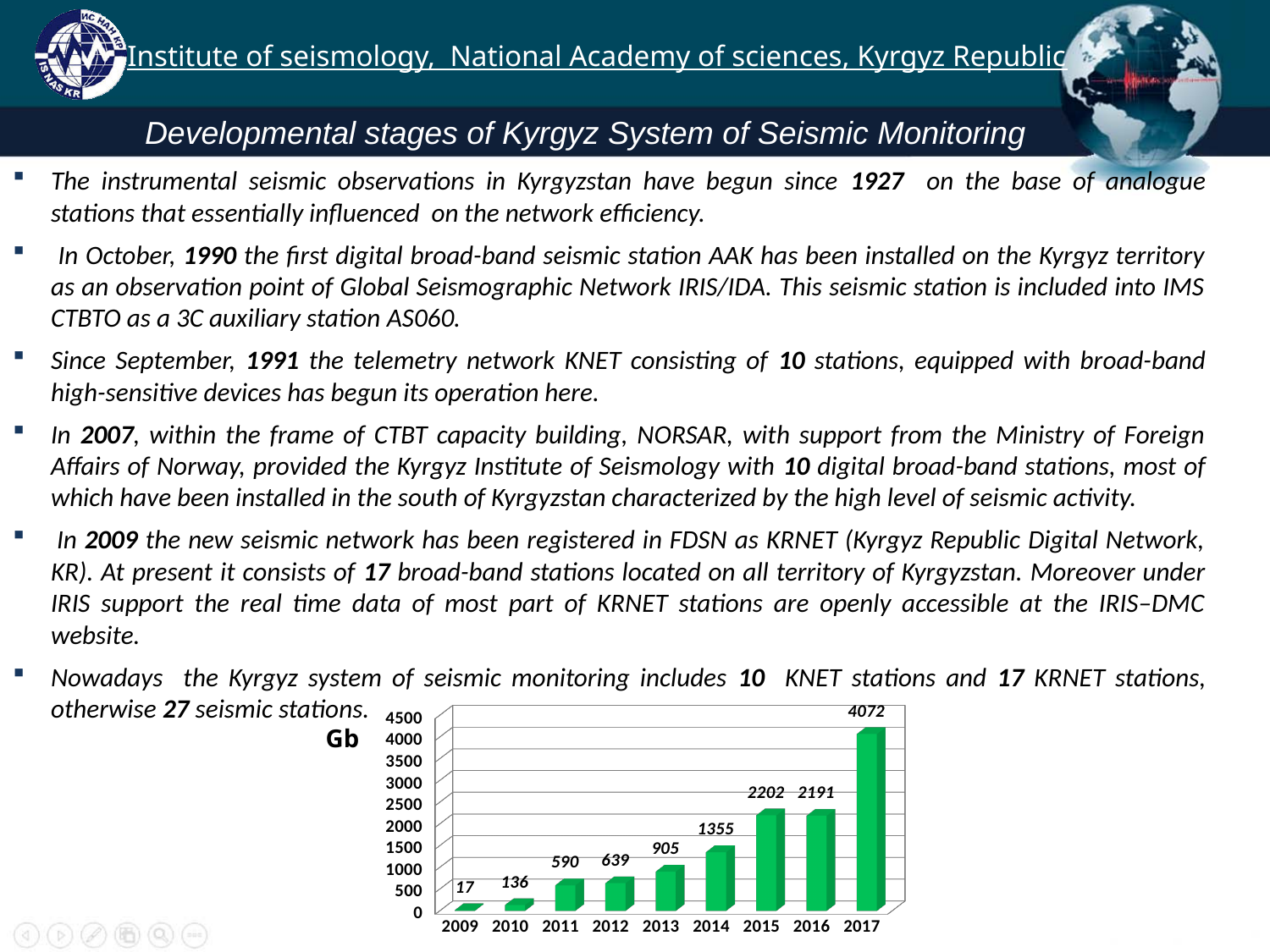
How many years are shown on the x axis of the bar chart? 9 What is the difference between the values for 2013 and 2012 in the bar chart? 266 What kind of chart is shown on the slide? bar chart Which year has the lowest value in the bar chart? 2009 What is the value for 2017 in the bar chart? 4072 Which year has the highest value in the bar chart? 2017 Which is larger in the bar chart, the value for 2015 or the value for 2014? 2015 What unit label is shown next to the vertical axis of the bar chart? Gb What is the value for 2009 in the bar chart? 17 What is the difference between the values for 2017 and 2016 in the bar chart? 1881 What is the value for 2014 in the bar chart? 1355 Is the value for 2016 in the bar chart greater or less than 2000? greater